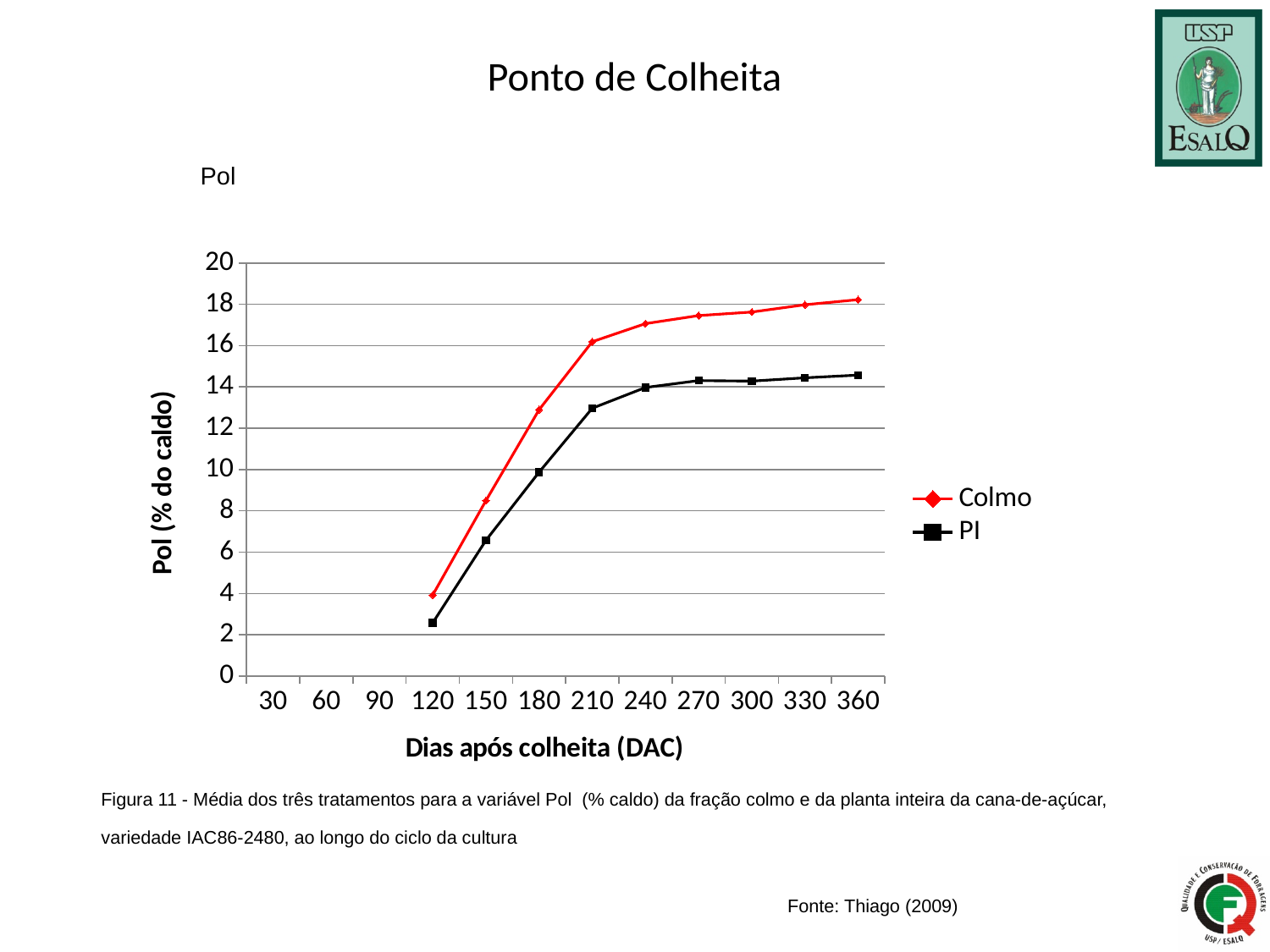
Is the Pol value for Colmo at 120 DAC greater or less than 6? less Is the Pol value for Colmo at 210 DAC greater or less than 14? greater Which colour is used for the PI series line? black At 240 DAC, which series has the higher Pol value, Colmo or PI? Colmo How many data points are plotted for the Colmo series? 9 Is the Pol value for Colmo at 360 DAC greater or less than 16? greater How many series does the legend list? 2 Do the Pol values for the PI series rise or fall as days after harvest increase? rise What kind of chart is shown on the slide? line chart What is the title of the x axis? Dias após colheita (DAC)